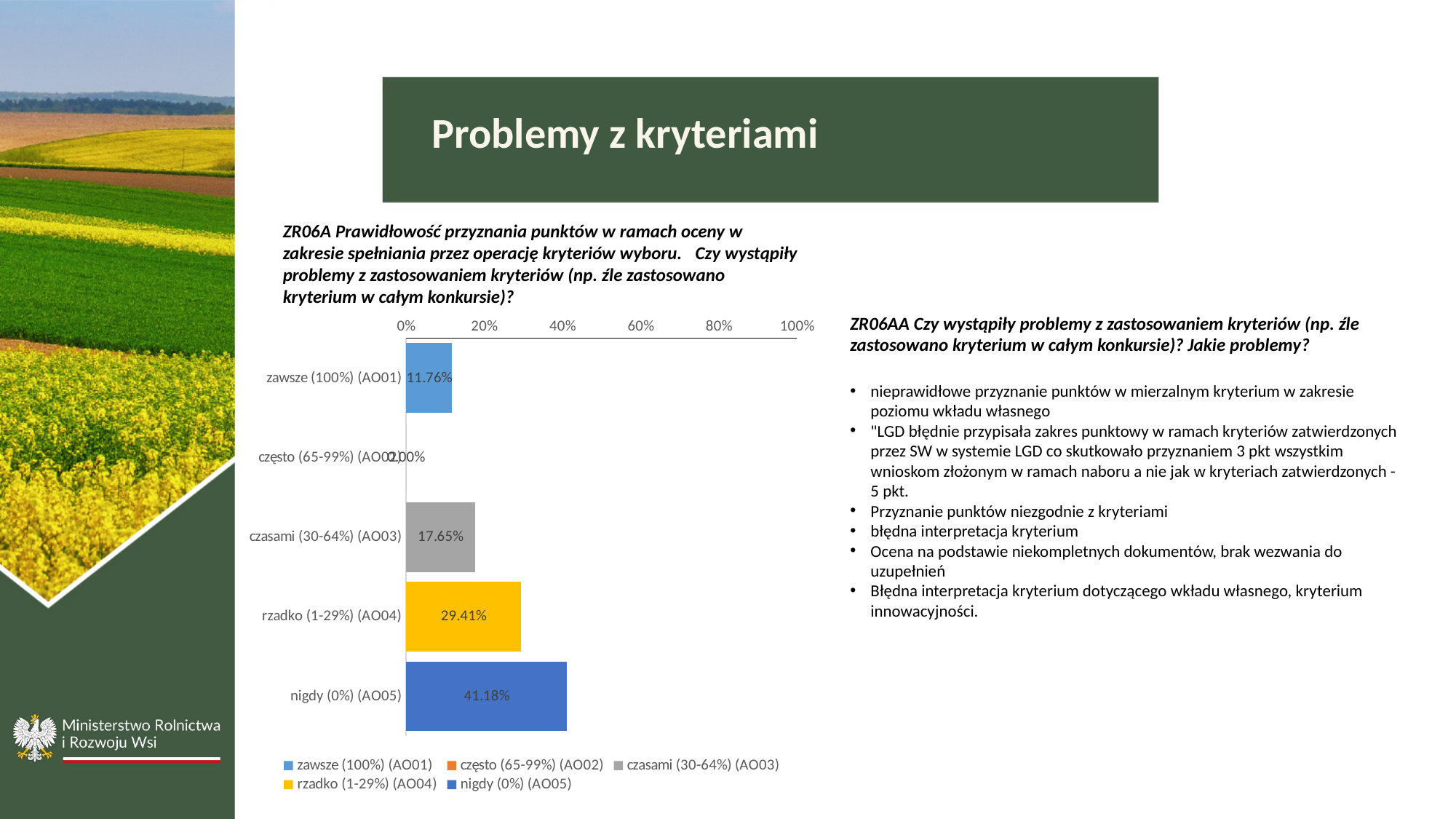
What is the value for nigdy (0%) (AO05)? 41.18% What is the value for często (65-99%) (AO02)? 0.00% Which category has the lowest value? często (65-99%) (AO02) Is the value for nigdy (0%) (AO05) greater or less than 40%? greater What is the value for czasami (30-64%) (AO03)? 17.65% What is the value for rzadko (1-29%) (AO04)? 29.41% Which is larger, the value for czasami (30-64%) (AO03) or the value for zawsze (100%) (AO01)? czasami (30-64%) (AO03) How many categories are shown in the chart? 5 What is the difference between the values for nigdy (0%) (AO05) and rzadko (1-29%) (AO04)? 11.77% Which category has the highest value? nigdy (0%) (AO05) What kind of chart is shown on the slide? bar chart What is the value for zawsze (100%) (AO01)? 11.76%